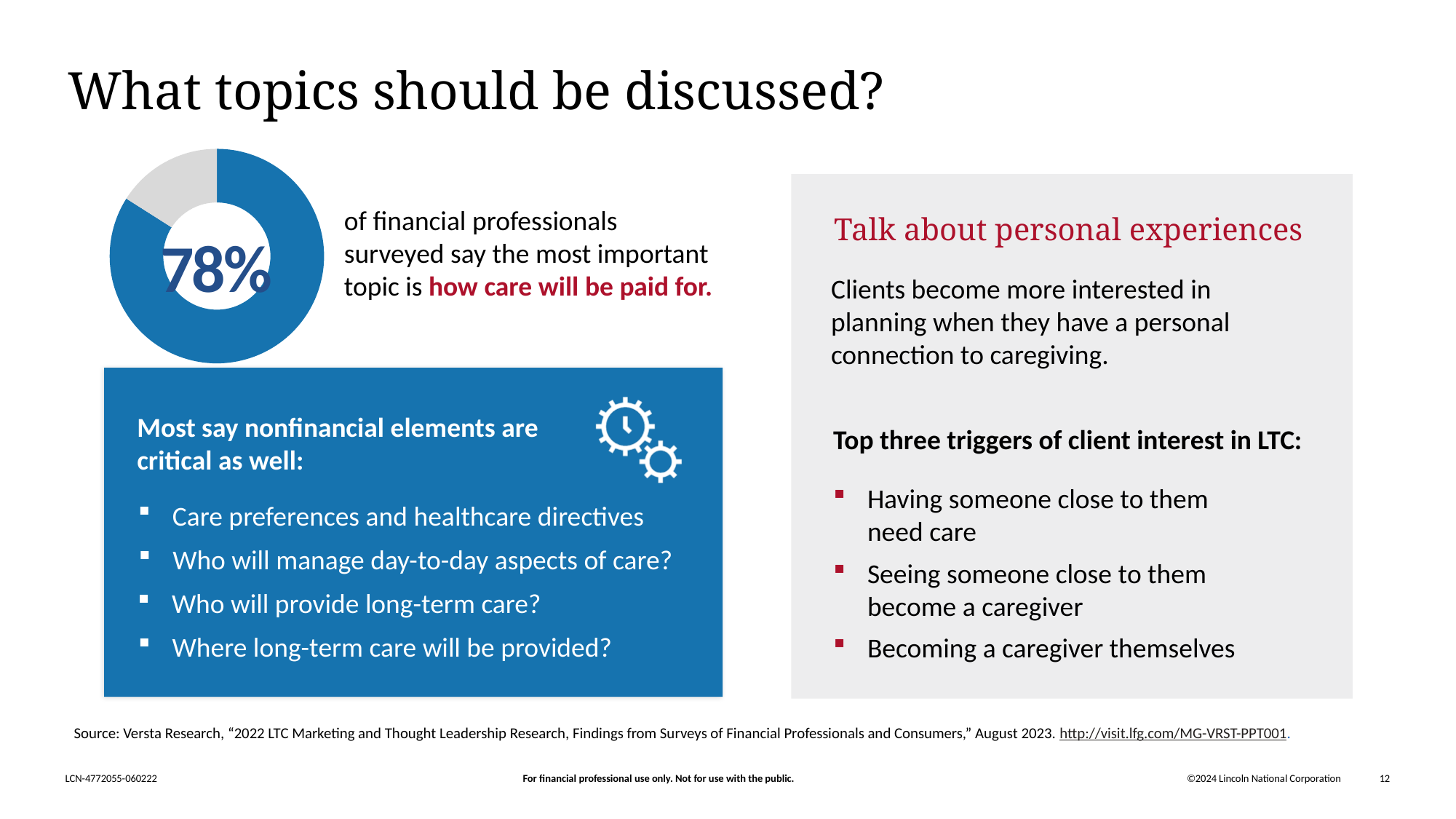
What percentage is printed in the centre of the donut chart? 78% According to the donut chart, what percentage of financial professionals surveyed say the most important topic is how care will be paid for? 78% What topic does the 78% in the donut chart refer to as the most important? How care will be paid for Which segment of the donut chart is larger, the blue one or the grey one? Blue Is the grey segment of the donut chart greater or less than 50%? less How many segments does the donut chart have? 2 Is the blue segment of the donut chart greater or less than 50%? greater What colour is the segment of the donut chart that represents 78%? Blue What kind of chart is shown on the left of the slide? Donut (pie) chart